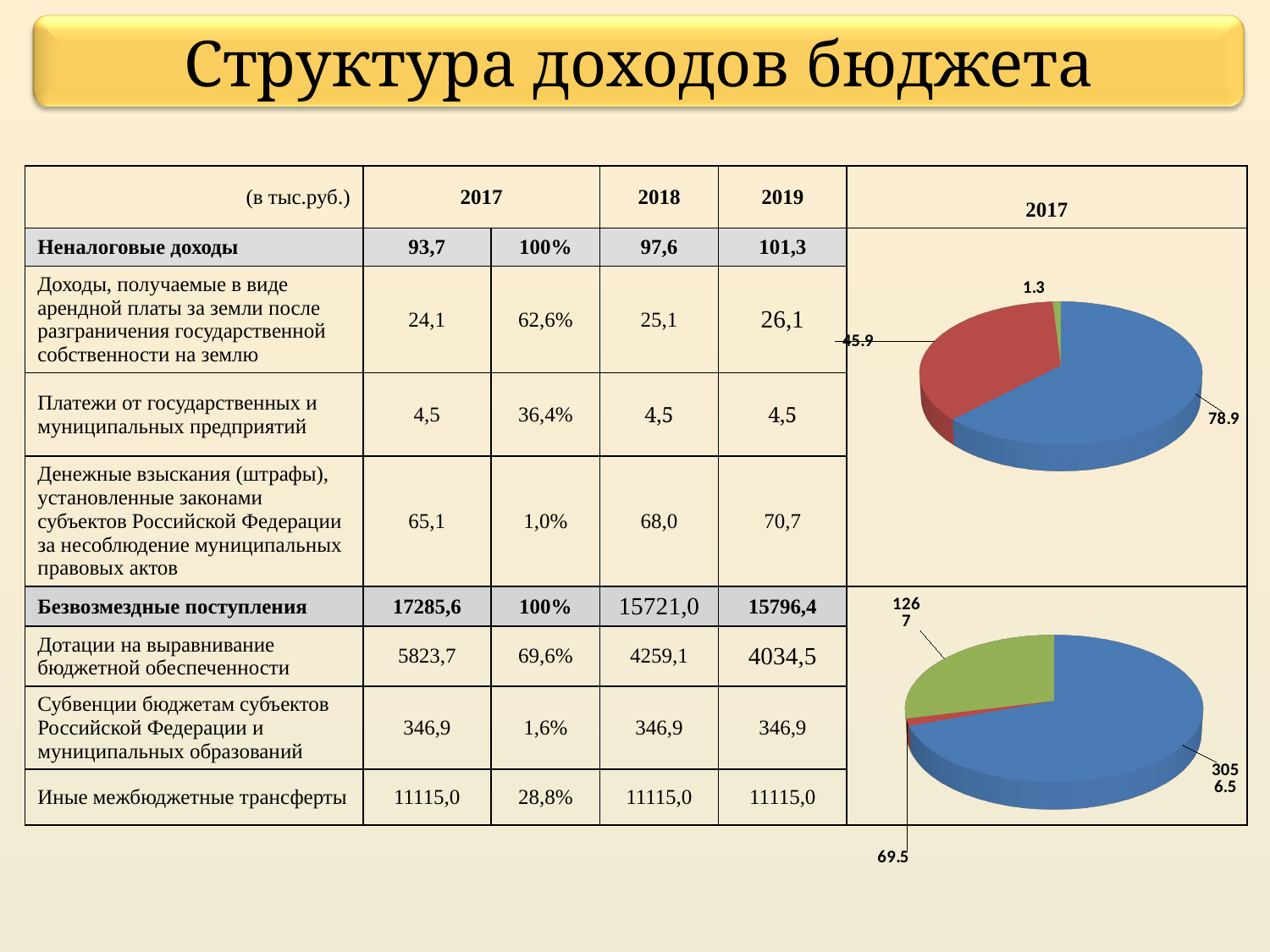
In the upper pie chart (titled 2017), what is the value labelled on the smallest slice? 1.3 What kind of chart is the upper chart on the right of the slide? pie chart In the upper pie chart (titled 2017), what is the difference between the values labelled on the blue slice (78.9) and the red slice (45.9)? 33.0 What kind of chart is the lower chart on the right of the slide? pie chart In the upper pie chart (titled 2017), what is the value labelled on the largest slice? 78.9 In the upper pie chart (titled 2017), which colour is the largest slice? blue How many slices does the lower pie chart have? 3 What is the title of the upper pie chart? 2017 In the upper pie chart (titled 2017), what value is labelled on the green slice? 1.3 In the upper pie chart (titled 2017), what value is labelled on the red slice? 45.9 In the upper pie chart (titled 2017), which slice is larger, the blue one or the red one? blue How many slices does the upper pie chart (titled 2017) have? 3